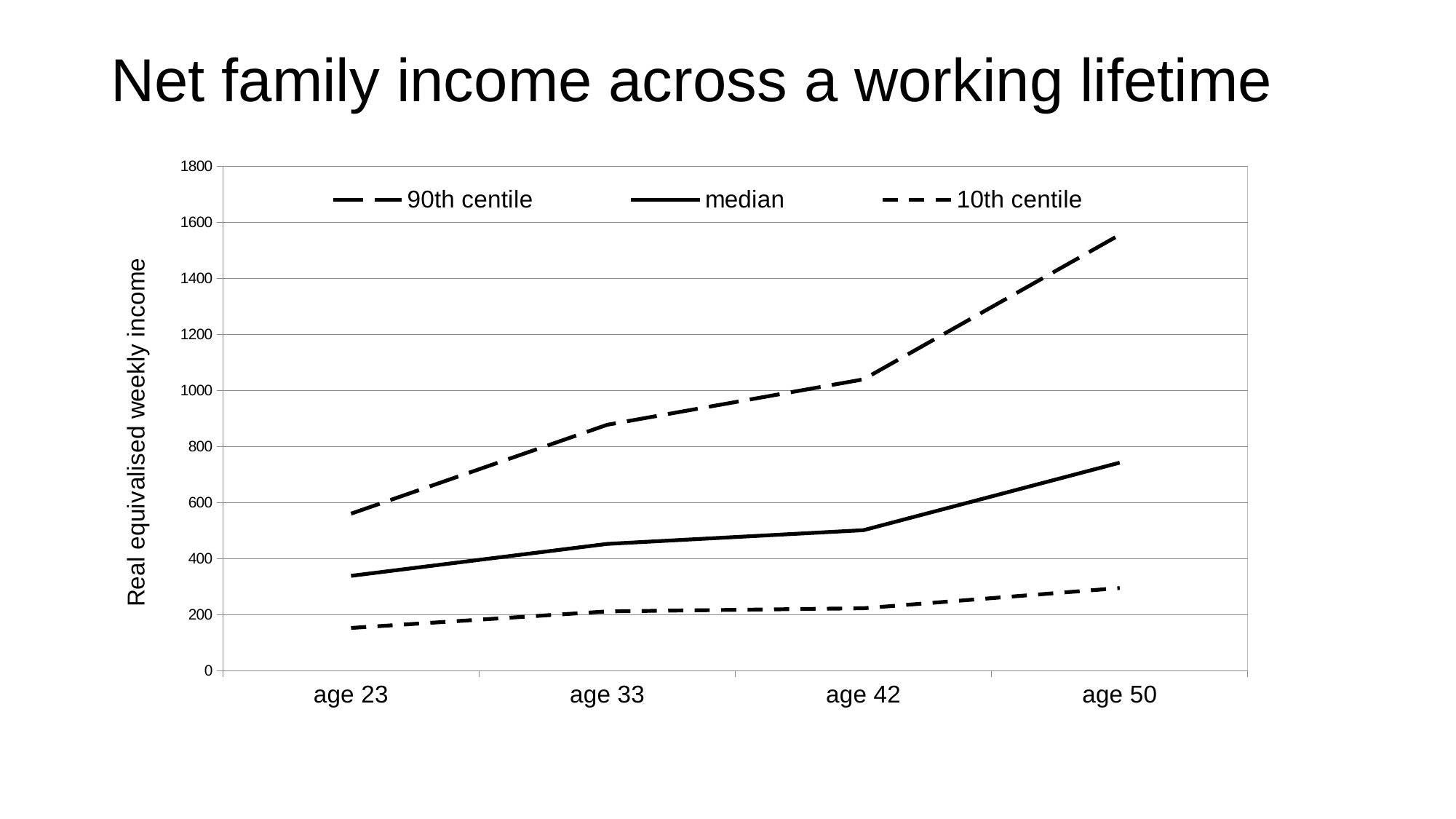
Is the median value at age 50 greater or less than 600? greater Is the 90th centile value at age 50 greater or less than 1400? greater What is the label on the vertical axis? Real equivalised weekly income Is the median value at age 23 greater or less than 400? less Which series has the lowest value at age 23? 10th centile How many series does the legend list? 3 How many age points are plotted along the x axis? 4 Which series has the highest value at age 50? 90th centile Which is larger: the median at age 50 or the 90th centile at age 23? median at age 50 What kind of chart is shown on the slide? line chart Does the 90th centile line rise or fall from age 23 to age 50? rise